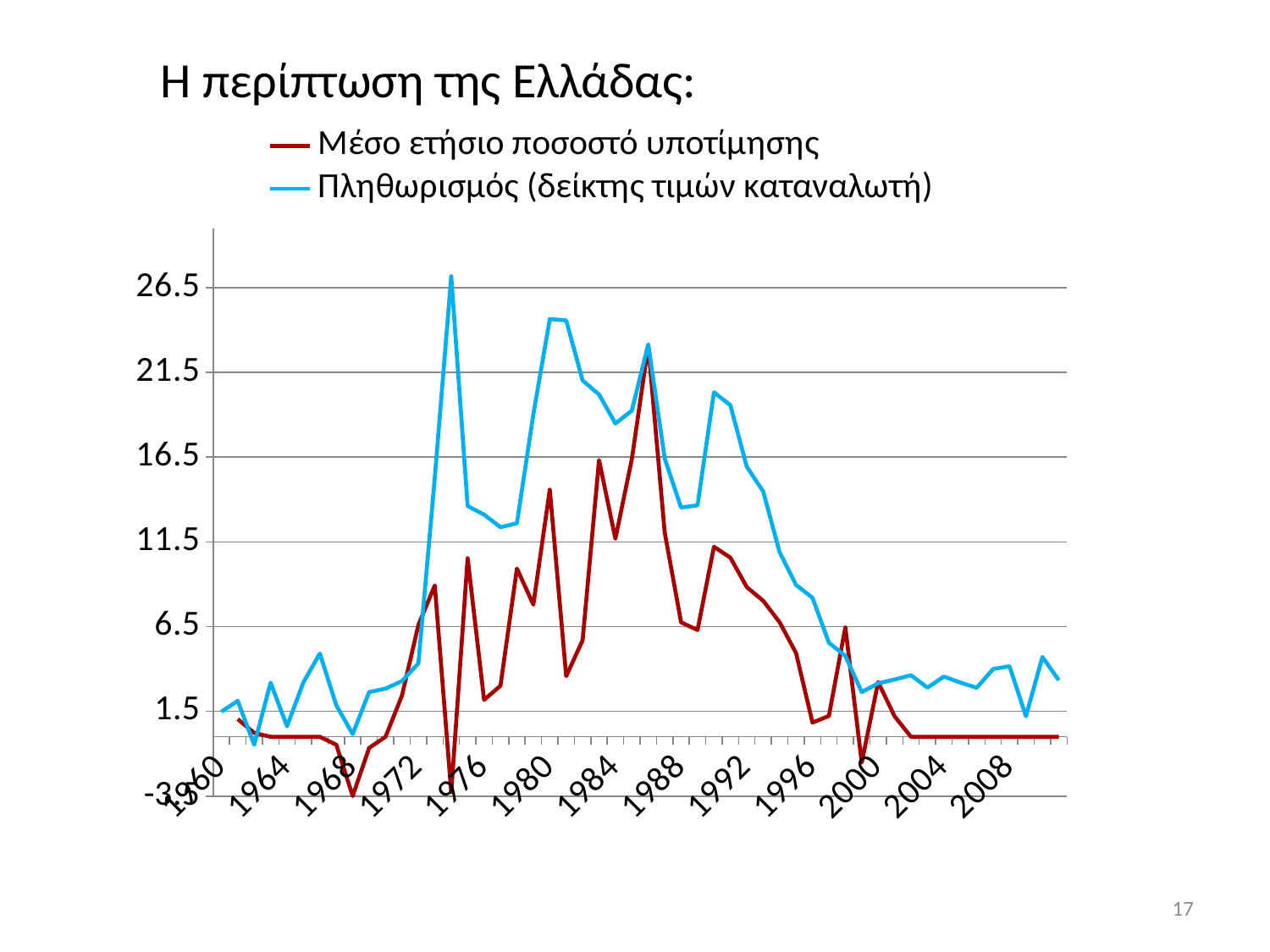
In 1974, which series has the higher value, Πληθωρισμός (δείκτης τιμών καταναλωτή) or Μέσο ετήσιο ποσοστό υποτίμησης? Πληθωρισμός (δείκτης τιμών καταναλωτή) Which series is drawn in red? Μέσο ετήσιο ποσοστό υποτίμησης In 1996, which series has the higher value, Πληθωρισμός (δείκτης τιμών καταναλωτή) or Μέσο ετήσιο ποσοστό υποτίμησης? Πληθωρισμός (δείκτης τιμών καταναλωτή) Is the value of Πληθωρισμός (δείκτης τιμών καταναλωτή) at its 1974 peak greater or less than 21.5? greater Is the value of Πληθωρισμός (δείκτης τιμών καταναλωτή) in 1980 greater or less than 16.5? greater How many series does the legend list? 2 What kind of chart is shown on the slide? line chart What is the title of the slide above the chart? Η περίπτωση της Ελλάδας: Is the value of Πληθωρισμός (δείκτης τιμών καταναλωτή) in 2004 greater or less than 6.5? less Does the Πληθωρισμός (δείκτης τιμών καταναλωτή) series generally rise or fall between 1992 and 2000? fall